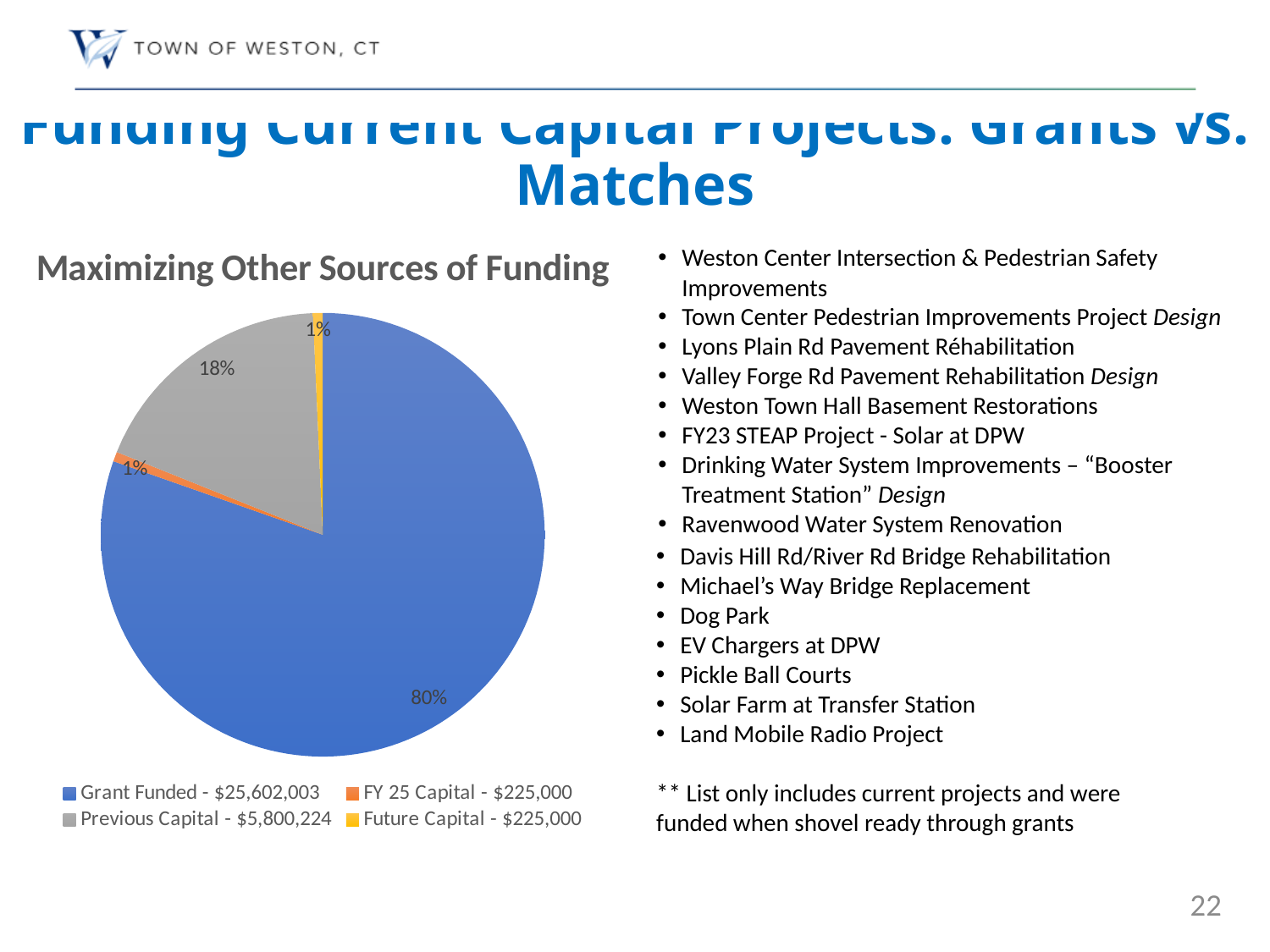
How many entries does the chart legend list? 4 How many slices does the pie chart have? 4 What share of the pie is Previous Capital? 18% Which category has the largest slice of the pie? Grant Funded What share of the pie is FY 25 Capital? 1% What share of the pie is Grant Funded? 80% What is the difference in percentage points between the Grant Funded share and the Previous Capital share? 62 percentage points Which is larger, the Grant Funded slice or the Previous Capital slice? Grant Funded What dollar amount does the legend give for Grant Funded? $25,602,003 What kind of chart is shown on the slide? pie chart What dollar amount does the legend give for Previous Capital? $5,800,224 What is the title of the chart? Maximizing Other Sources of Funding